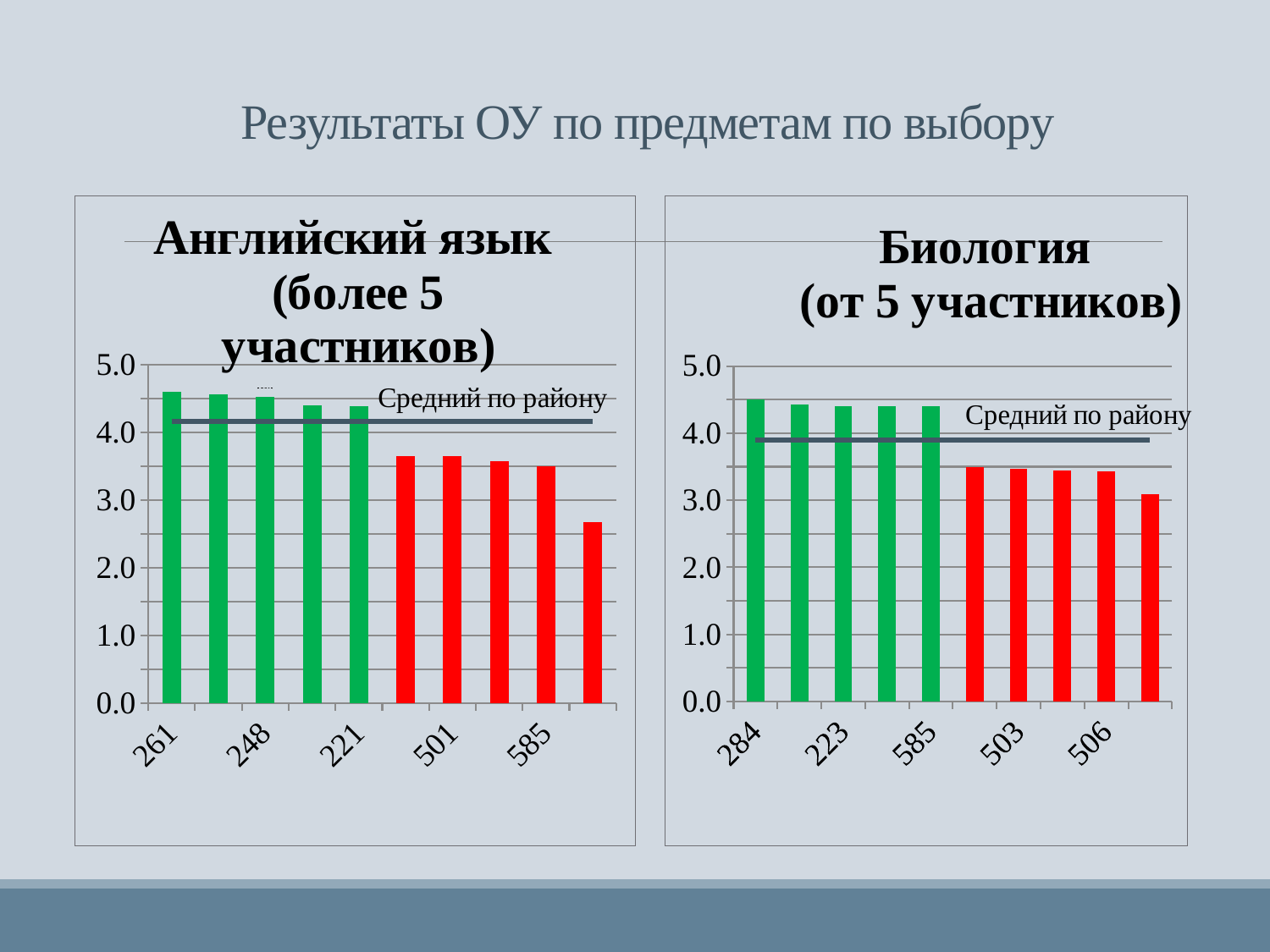
In the left chart (Английский язык), is the value for 261 greater or less than 4.0? greater In the right chart (Биология), do the bar values rise or fall from left to right along the x axis? fall In the right chart (Биология), how many bars are plotted? 10 What kind of chart is the left chart titled "Английский язык (более 5 участников)"? bar chart In the left chart (Английский язык), is the value for 585 greater or less than 4.0? less In the right chart (Биология), is the value for 284 greater or less than 4.0? greater In the left chart (Английский язык), which has the larger value, 261 or 501? 261 In the left chart (Английский язык), how many bars are plotted? 10 In the right chart (Биология), which has the larger value, 223 or 503? 223 What is the label of the horizontal line drawn across the bars in both charts? Средний по району